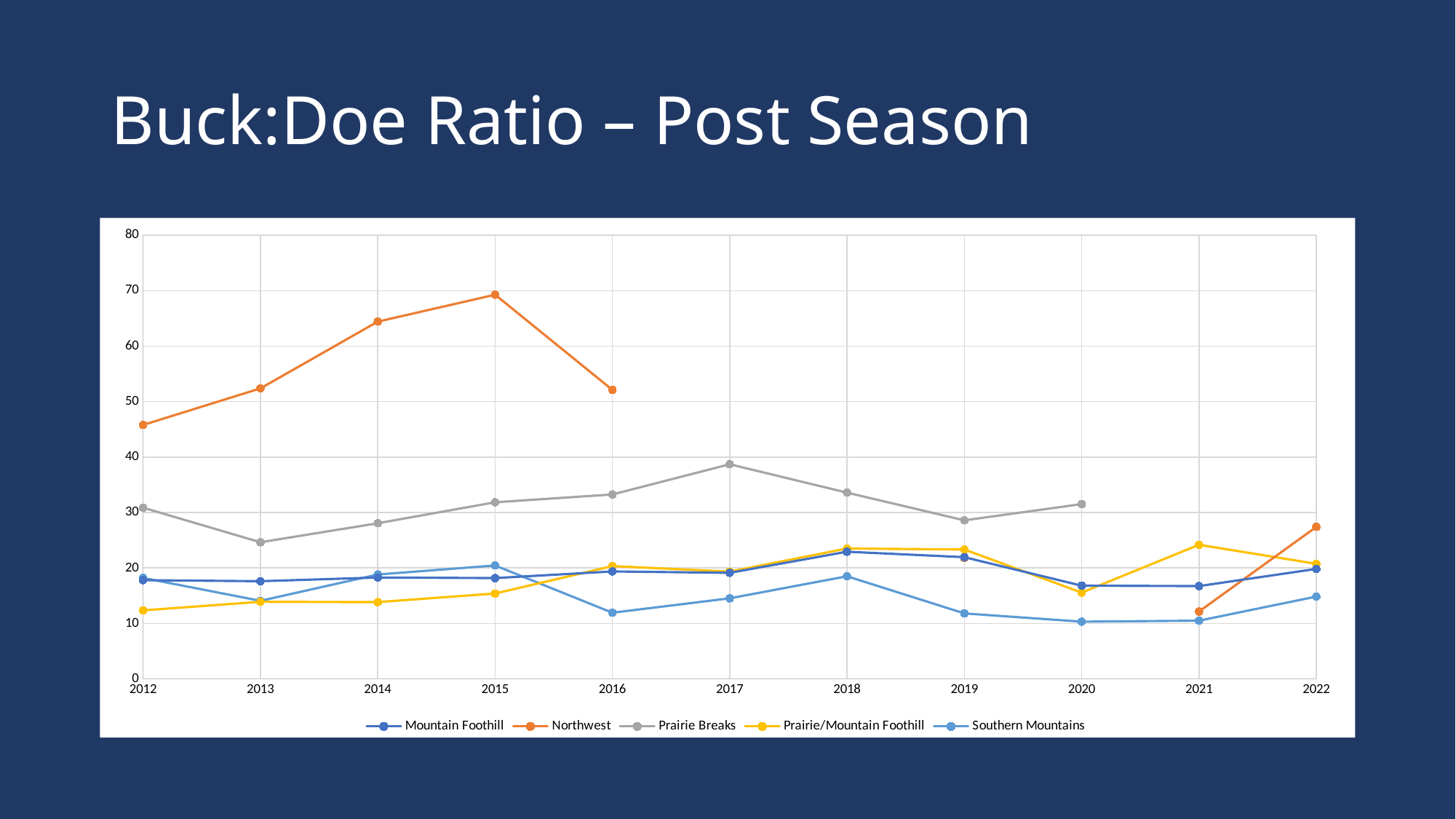
Which series has the lowest value in 2020? Southern Mountains Is the value for Prairie Breaks in 2017 greater or less than 30? greater What is the title of the slide? Buck:Doe Ratio – Post Season Which series has the highest value in 2015? Northwest How many years are shown along the x axis? 11 Does the Northwest series rise or fall from 2012 to 2015? rise How many series does the legend list? 5 Is the value for Southern Mountains in 2016 greater or less than 20? less What kind of chart is shown on the slide? line chart In which year does the Northwest series reach its highest value? 2015 In 2013, which is larger: Prairie Breaks or Mountain Foothill? Prairie Breaks Is the value for Northwest in 2015 greater or less than 60? greater